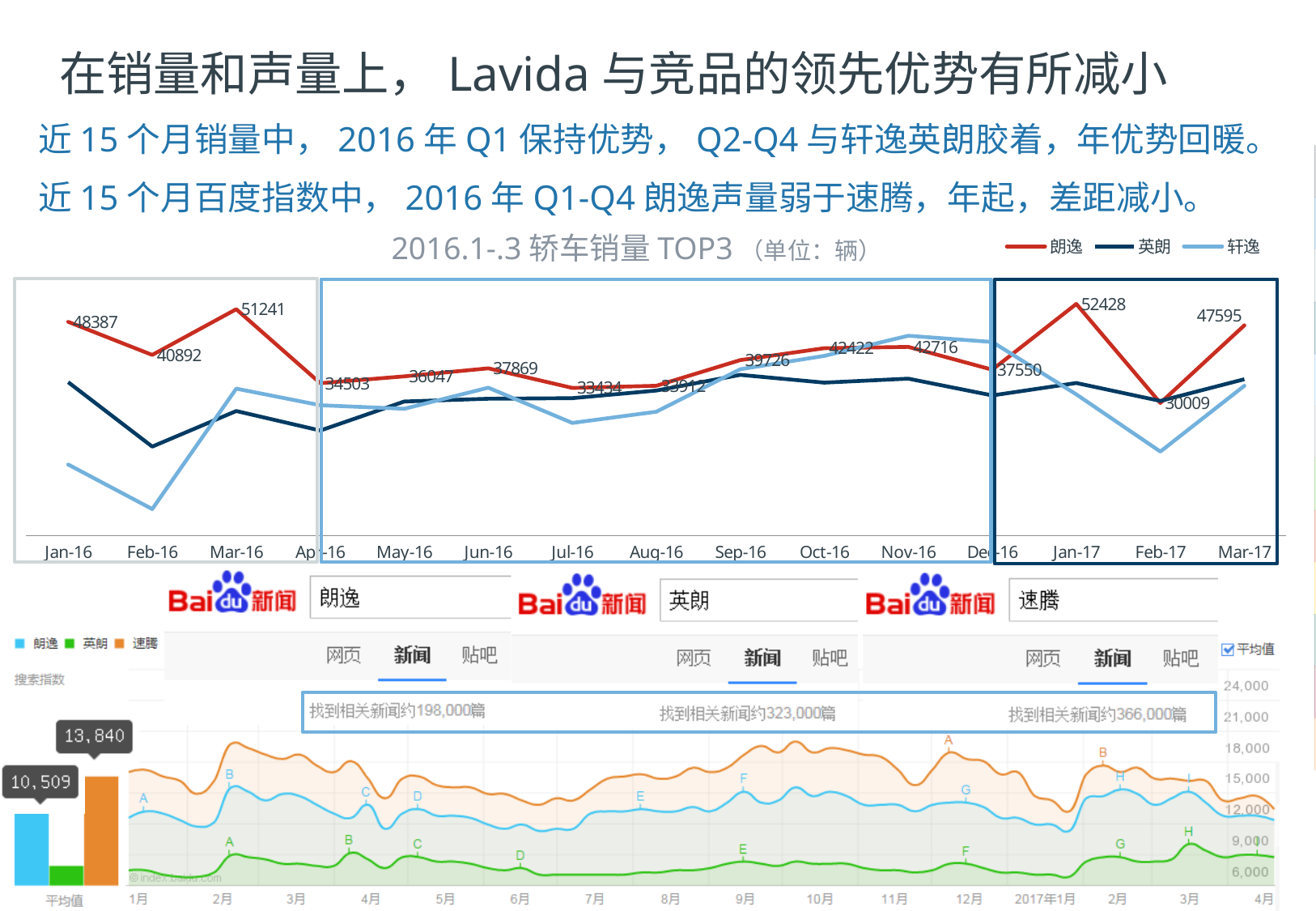
In the top chart titled 2016.1-.3 轿车销量 TOP3, in which month does 朗逸 reach its highest value? Jan-17 In the top chart titled 2016.1-.3 轿车销量 TOP3, what is the value for 朗逸 in Feb-17? 30009 In the top chart titled 2016.1-.3 轿车销量 TOP3, what is the value for 朗逸 in Jan-17? 52428 What kind of chart is the top chart titled 2016.1-.3 轿车销量 TOP3? line chart In the top chart titled 2016.1-.3 轿车销量 TOP3, what is the difference between the 朗逸 values for Jan-17 and Feb-17? 22419 In the top chart titled 2016.1-.3 轿车销量 TOP3, which is larger for 朗逸: Jan-16 or Feb-16? Jan-16 In the bottom-left 平均值 bar chart, what is the difference between the 速腾 and 朗逸 averages? 3,331 In the bottom-left 平均值 bar chart, what is the average value shown for 速腾? 13,840 In the top chart titled 2016.1-.3 轿车销量 TOP3, how many months are shown on the x axis? 15 In the top chart titled 2016.1-.3 轿车销量 TOP3, what is the value for 朗逸 in Mar-16? 51241 In the top chart titled 2016.1-.3 轿车销量 TOP3, in which month does 朗逸 reach its lowest value? Feb-17 In the top chart titled 2016.1-.3 轿车销量 TOP3, how many series does the legend list? 3